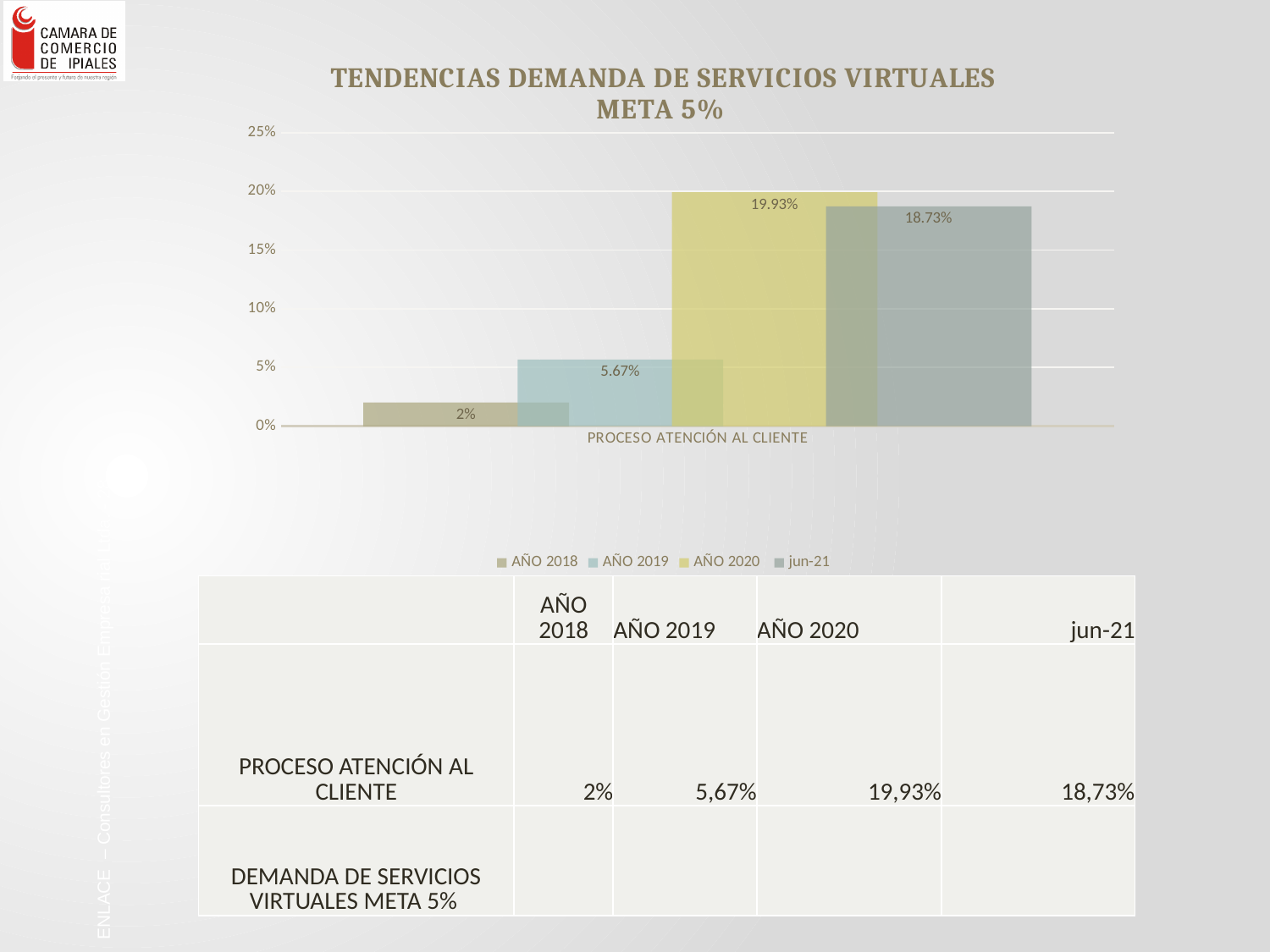
What is the value for jun-21 in the PROCESO ATENCIÓN AL CLIENTE category? 18.73% What is the title of the chart? TENDENCIAS DEMANDA DE SERVICIOS VIRTUALES META 5% What is the value for AÑO 2020 in the PROCESO ATENCIÓN AL CLIENTE category? 19.93% Which series has the lowest value in the chart? AÑO 2018 How many series does the legend list? 4 What kind of chart is shown on the slide? Bar chart What is the difference between the AÑO 2019 value and the AÑO 2018 value? 3.67% What is the value for AÑO 2019 in the PROCESO ATENCIÓN AL CLIENTE category? 5.67% Which series has the highest value in the chart? AÑO 2020 Which is larger, the value for AÑO 2019 or the value for jun-21? jun-21 What is the value for AÑO 2018 in the PROCESO ATENCIÓN AL CLIENTE category? 2% What is the difference between the AÑO 2020 value and the jun-21 value? 1.20%